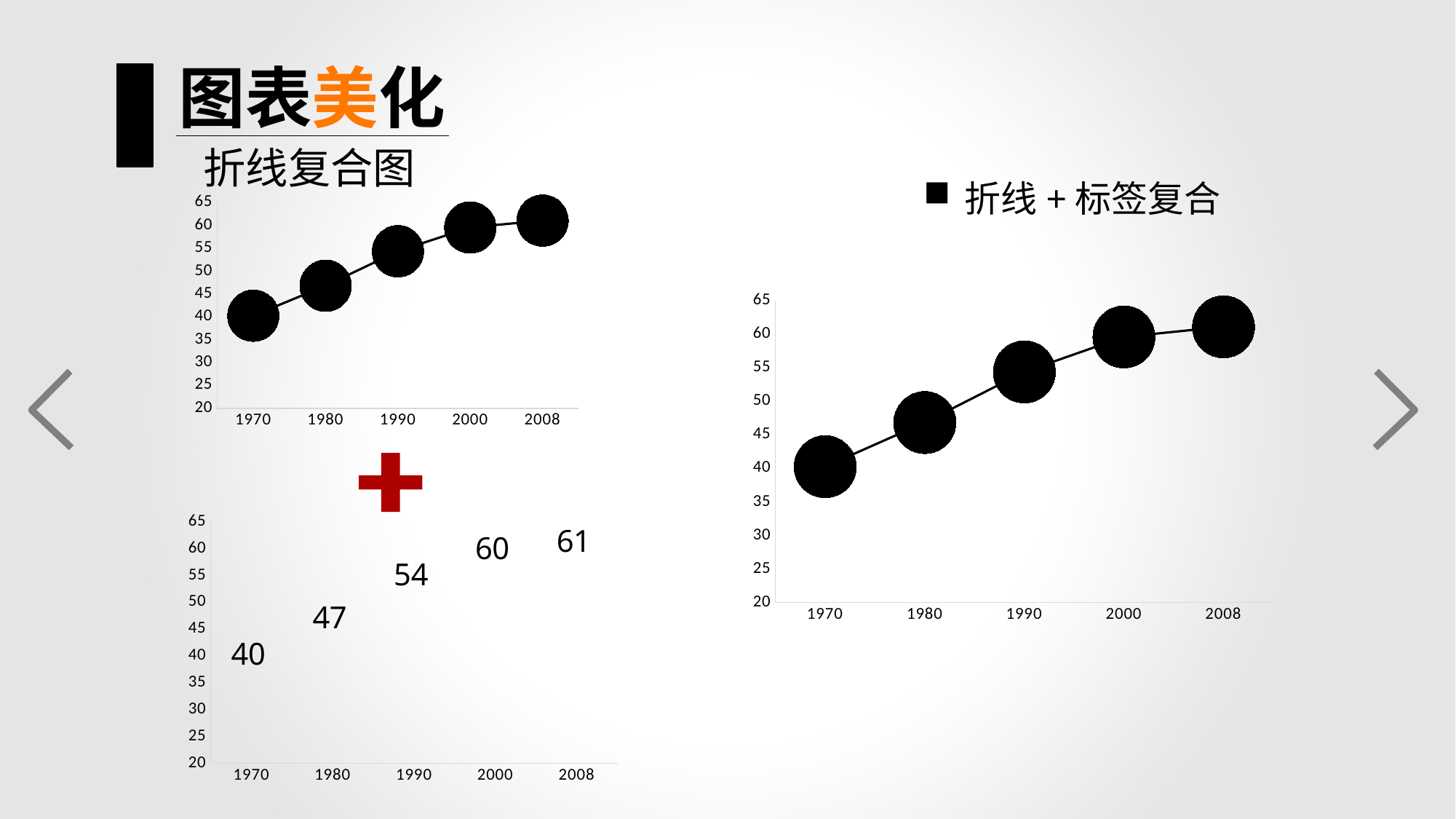
In the bottom-left chart, what is the value for 1970? 40 In the bottom-left chart, what is the value for 2008? 61 In the bottom-left chart, what is the value for 1990? 54 What kind of chart is the chart on the right? line chart In the bottom-left chart, what is the difference between the values for 1980 and 1970? 7 In the bottom-left chart, which year has the lowest value? 1970 How many x-axis categories does the chart on the right have? 5 In the bottom-left chart, which is larger, the value for 1990 or the value for 2000? 2000 In the bottom-left chart, which year has the highest value? 2008 In the top-left chart, is the value for 2000 greater or less than 55? greater In the chart on the right, do the values rise or fall from 1970 to 2008? rise In the chart on the right, is the value for 1970 greater or less than 45? less